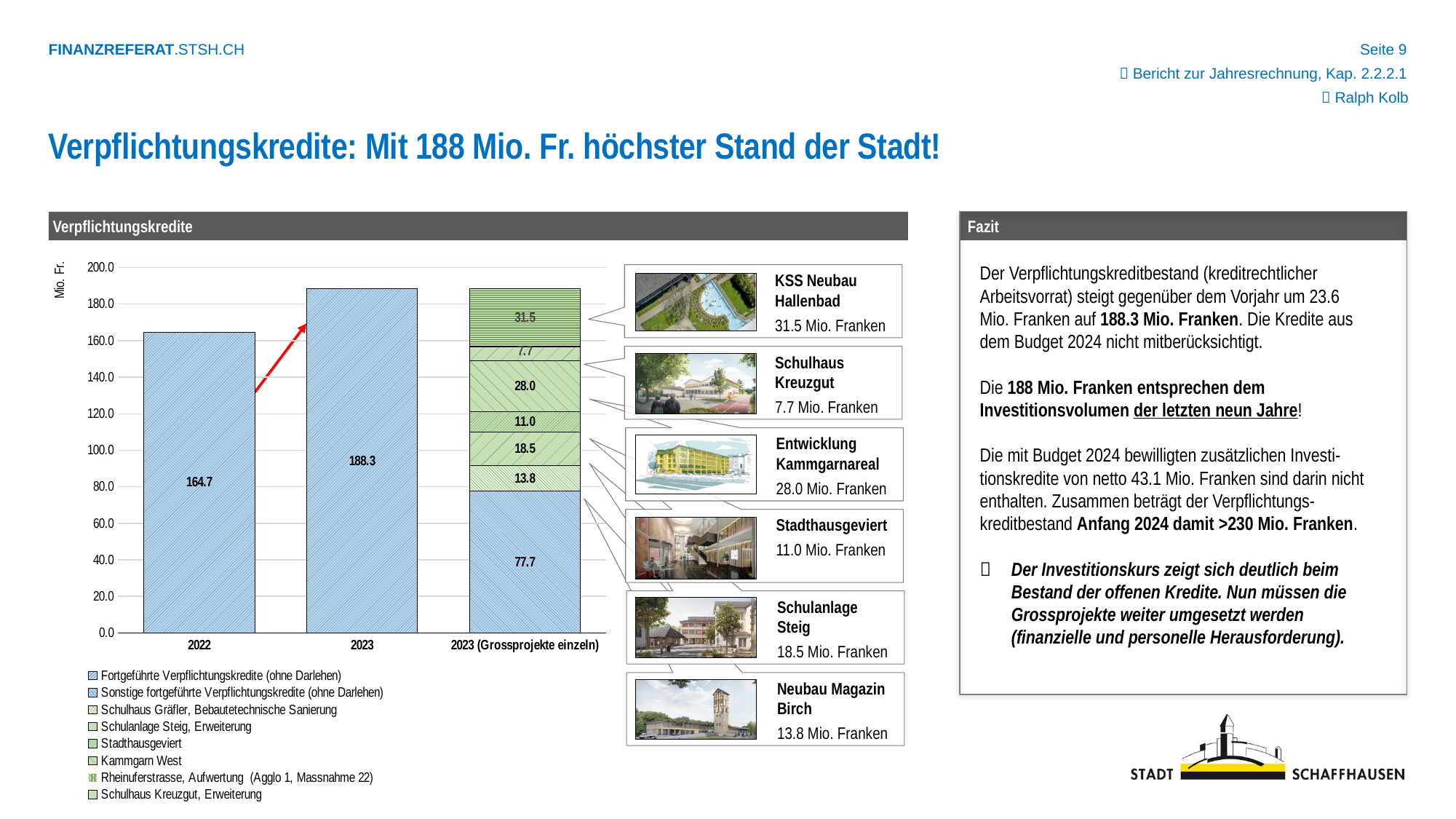
What is the value of the bar for 2022 in the Verpflichtungskredite chart? 164.7 Do the Verpflichtungskredite rise or fall from 2022 to 2023? rise What is the value of the bar for 2023 in the Verpflichtungskredite chart? 188.3 How many entries does the legend of the Verpflichtungskredite chart list? 8 Which bar is larger in the Verpflichtungskredite chart, 2022 or 2023? 2023 By how much does the 2023 bar exceed the 2022 bar in the Verpflichtungskredite chart? 23.6 How many categories are shown on the x axis of the Verpflichtungskredite chart? 3 According to the callout next to the chart, how many Mio. Franken is the KSS Neubau Hallenbad? 31.5 Mio. Franken What kind of chart is shown under the heading 'Verpflichtungskredite'? bar chart What is the value of the largest (bottom) segment in the '2023 (Grossprojekte einzeln)' stacked bar? 77.7 According to the callout next to the chart, how many Mio. Franken is the Stadthausgeviert? 11.0 Mio. Franken Is the value for 2022 in the Verpflichtungskredite chart greater or less than 180? less